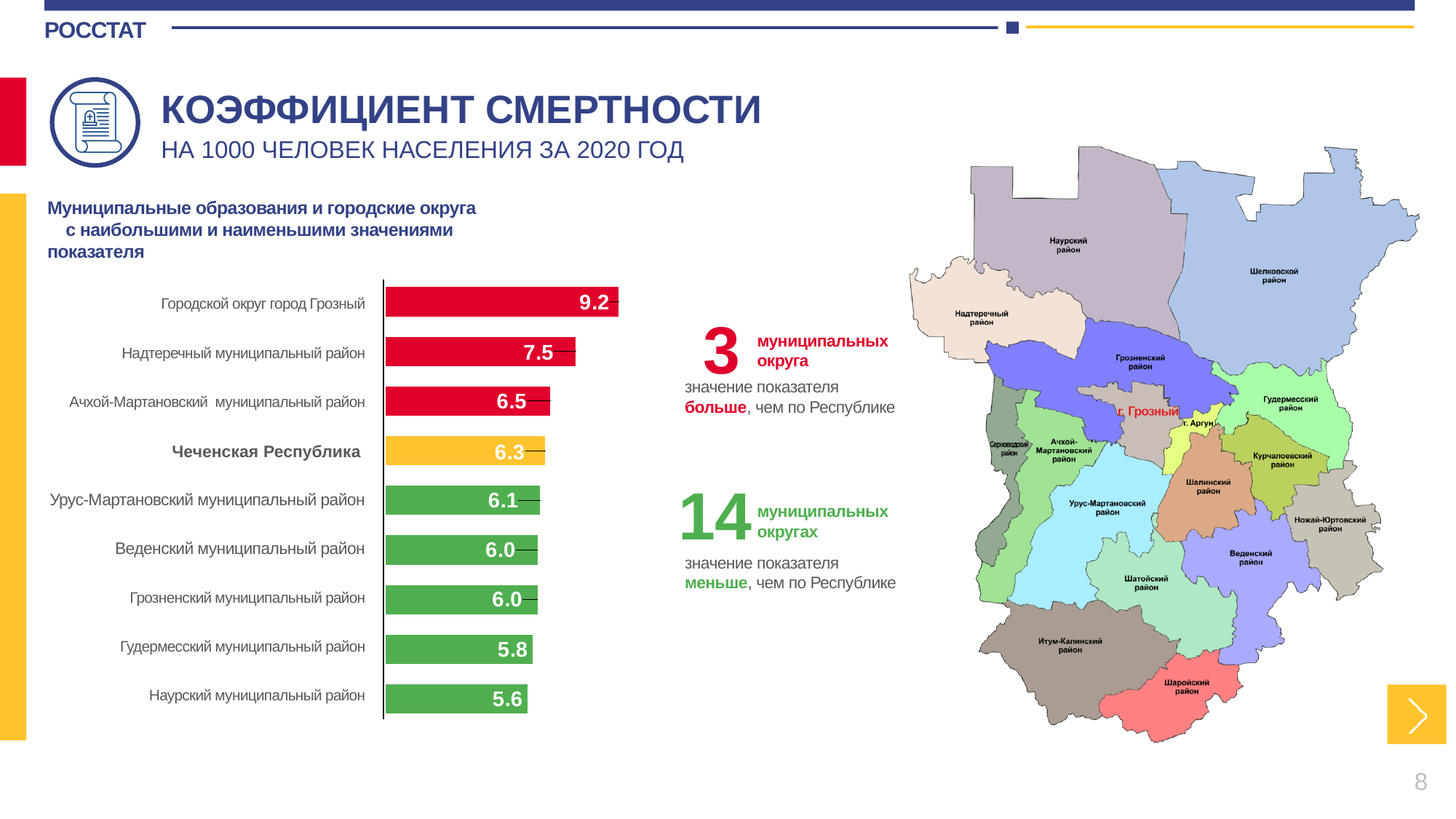
Which is larger: the value for Ачхой-Мартановский муниципальный район or Урус-Мартановский муниципальный район? Ачхой-Мартановский муниципальный район What kind of chart is used to show the mortality rate values? Bar chart What is the difference between the values for Городской округ город Грозный and Наурский муниципальный район? 3.6 What is the value for Надтеречный муниципальный район? 7.5 What is the value shown for Чеченская Республика? 6.3 What is the mortality rate value for Городской округ город Грозный? 9.2 What colour is the bar for Чеченская Республика? Yellow Which category has the highest value in the bar chart? Городской округ город Грозный What is the difference between the values for Надтеречный муниципальный район and Чеченская Республика? 1.2 Which category has the lowest value in the bar chart? Наурский муниципальный район How many categories (bars) are shown in the bar chart? 9 What is the value for Гудермесский муниципальный район? 5.8